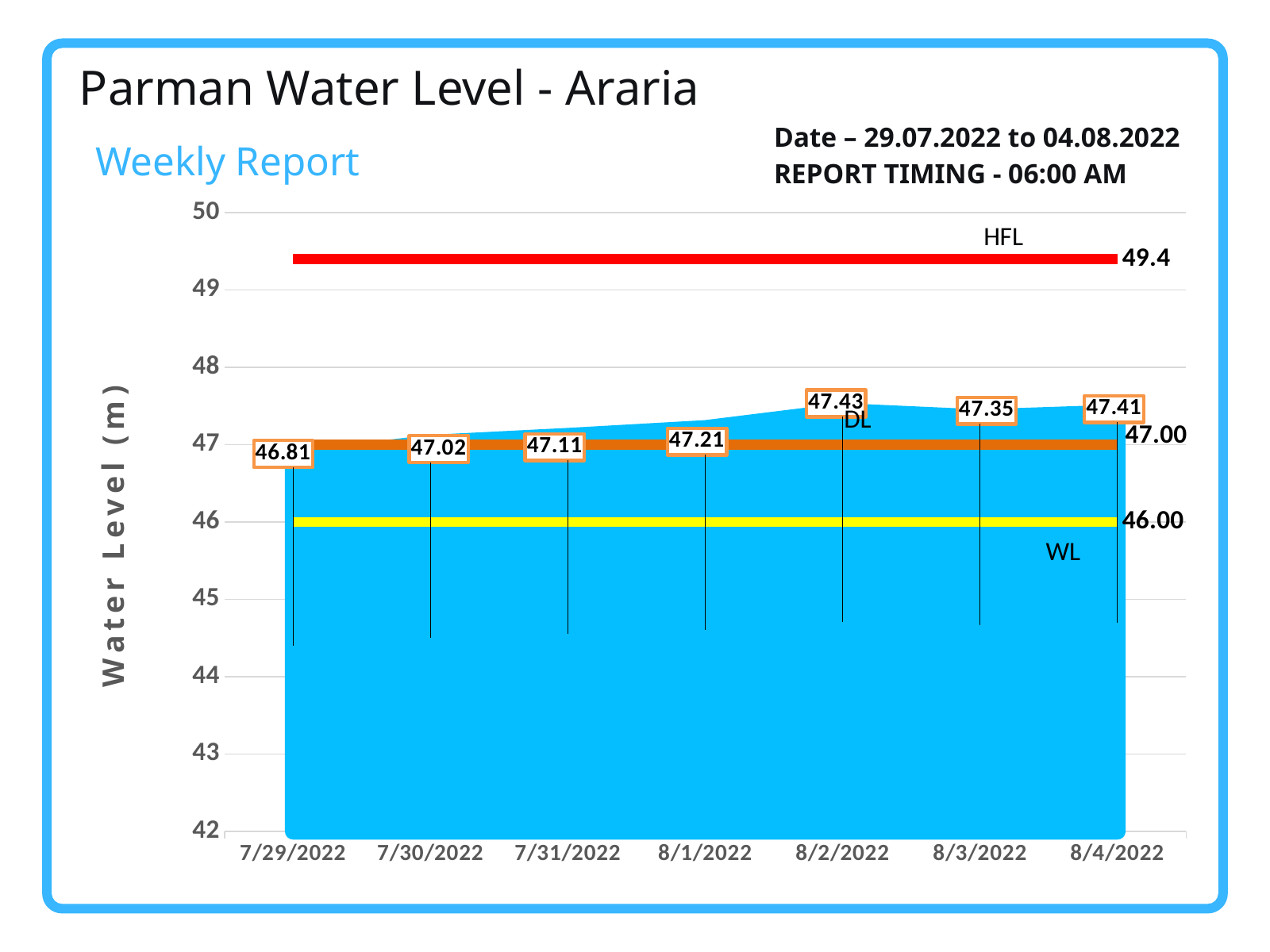
Is the water level on 7/30/2022 greater or less than 47? greater On which date is the water level highest? 8/2/2022 What is the water level on 8/4/2022? 47.41 What is the difference between the water level on 8/2/2022 and on 7/29/2022? 0.62 What value is shown for the DL line? 47.00 Which date has a higher water level, 7/31/2022 or 8/3/2022? 8/3/2022 What value is shown for the HFL line? 49.4 What is the water level on 8/2/2022? 47.43 On which date is the water level lowest? 7/29/2022 What is the title of the chart? Parman Water Level - Araria What is the water level on 7/29/2022? 46.81 How many dates are plotted on the x axis? 7